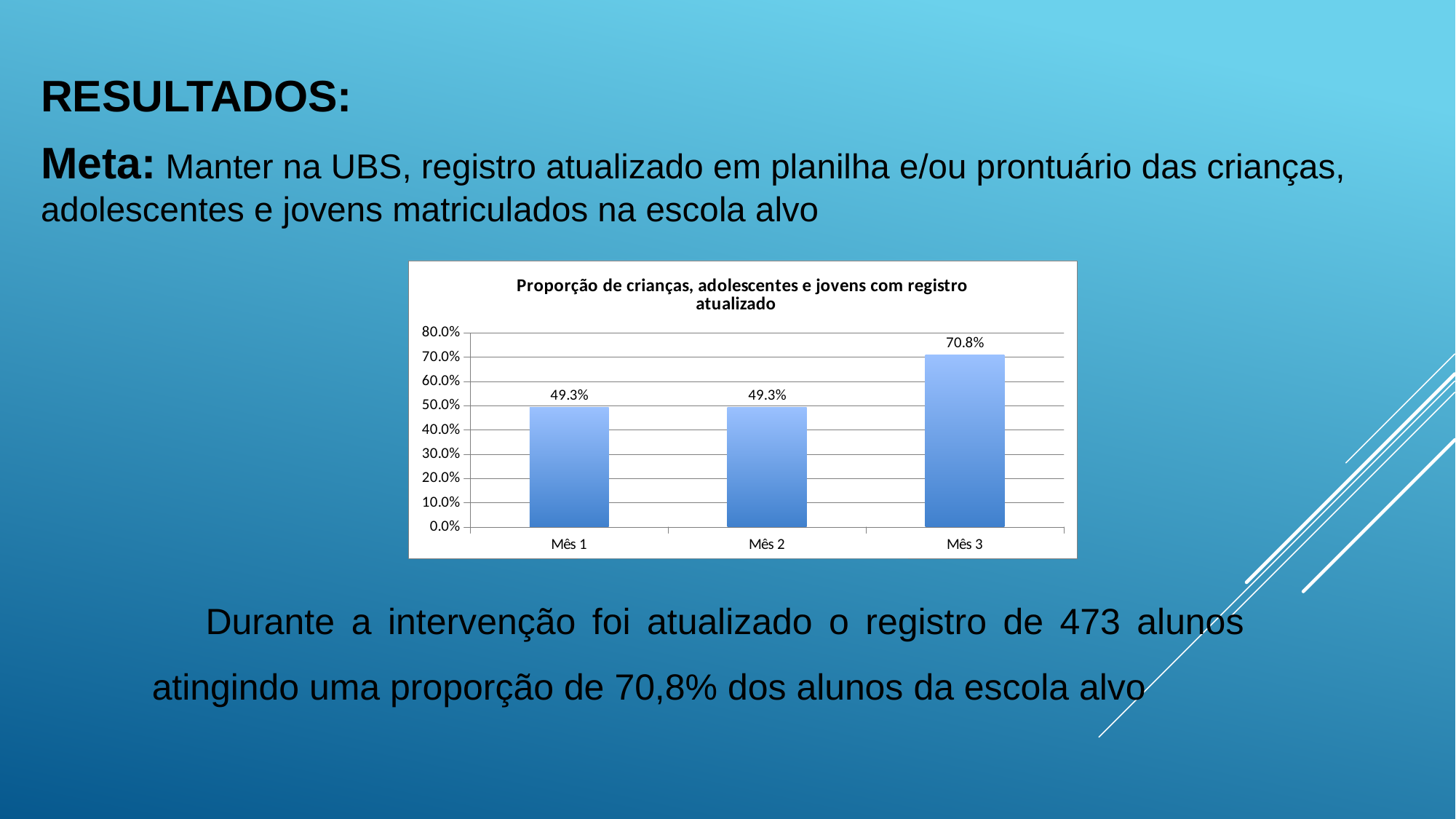
What is the difference between the values for Mês 3 and Mês 2? 21.5% Is the value for Mês 2 greater or less than 50.0%? less Do the values rise or fall from Mês 2 to Mês 3? Rise What kind of chart is shown on the slide? Bar chart Are the values for Mês 1 and Mês 2 the same or different? The same What is the value for Mês 3? 70.8% Is the value for Mês 3 greater or less than 60.0%? greater How many months are shown on the x axis? 3 What is the title of the chart? Proporção de crianças, adolescentes e jovens com registro atualizado Which month has the highest proportion? Mês 3 Which is larger, the value for Mês 1 or the value for Mês 3? Mês 3 What is the value for Mês 1? 49.3%